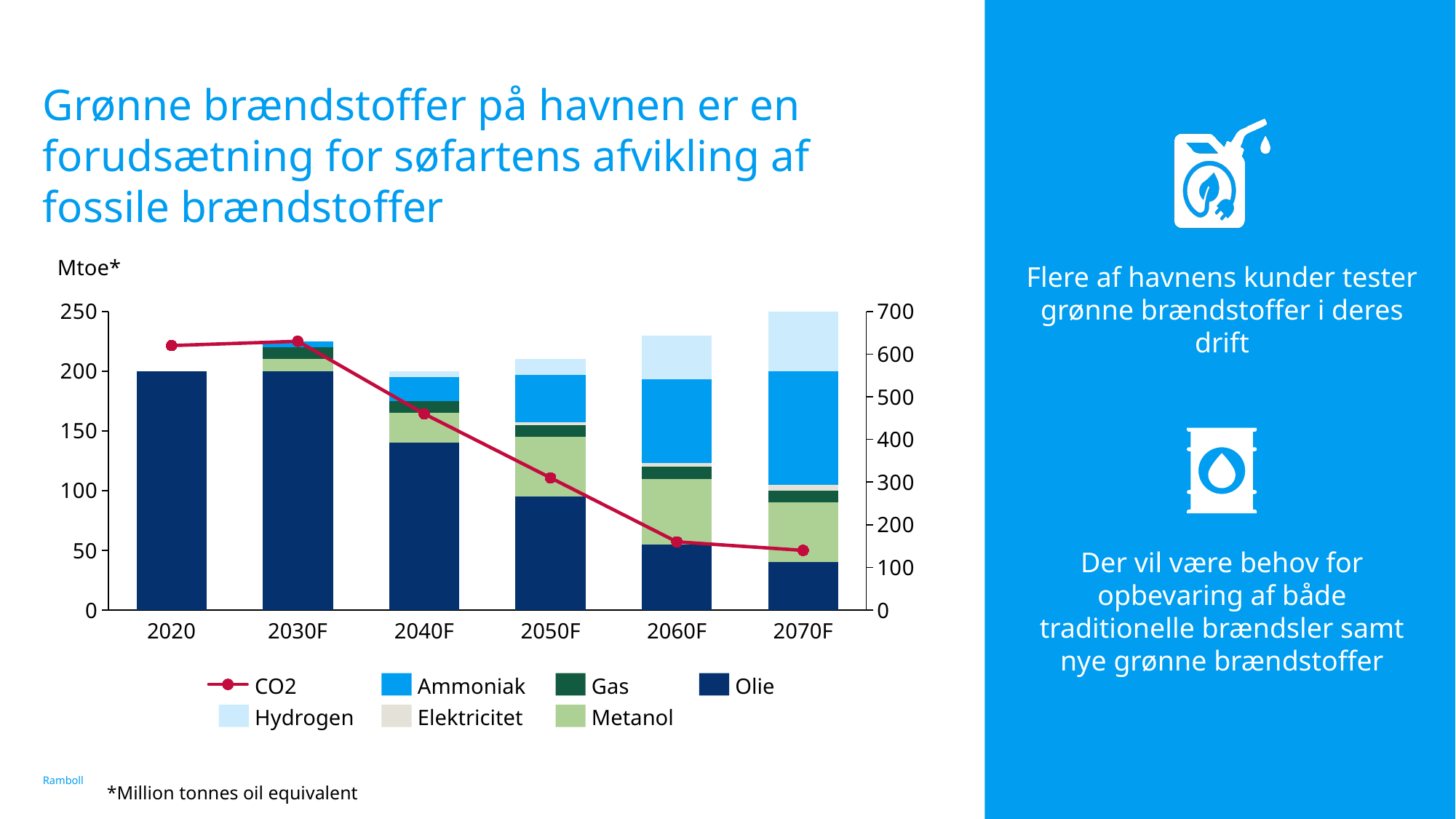
What kind of chart is shown on the slide? Stacked bar chart with a line Is the value for Olie in 2040F greater or less than 100? greater Which is larger, the Olie value in 2040F or in 2060F? 2040F How many series does the chart legend list? 7 Is the total height of the stacked bar for 2070F greater or less than 200? greater Which year has the smallest Olie value? 2070F What is the value of Olie in 2020? 200 Is the CO2 value for 2070F greater or less than 200 on the right axis? less How many years are shown on the x axis of the chart? 6 Does the CO2 line rise or fall from 2030F to 2070F? Fall Which year has the tallest stacked bar? 2070F